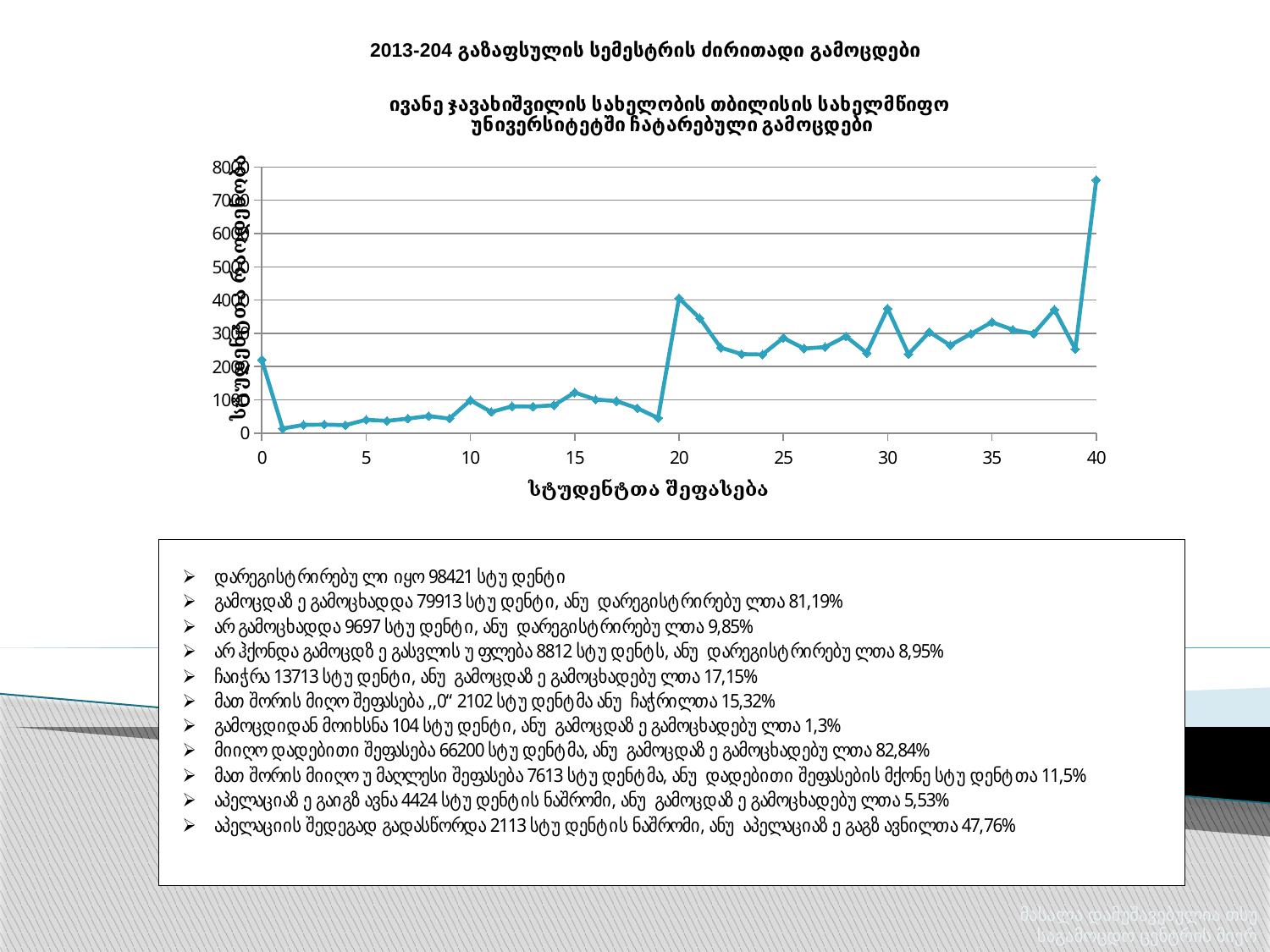
What kind of chart is shown on the slide? line chart What is the title of the x axis? სტუდენტთა შეფასება Is the value at x = 30 greater or less than 300? greater Is the value at x = 40 greater or less than 700? greater Which is larger, the value at x = 10 or the value at x = 30? x = 30 Is the value at x = 20 greater or less than 300? greater At which x-axis value does the line reach its lowest point? 1 At which x-axis value does the line reach its highest point? 40 Which is larger, the value at x = 5 or the value at x = 25? x = 25 Overall, do the values rise or fall from x = 0 to x = 40? rise